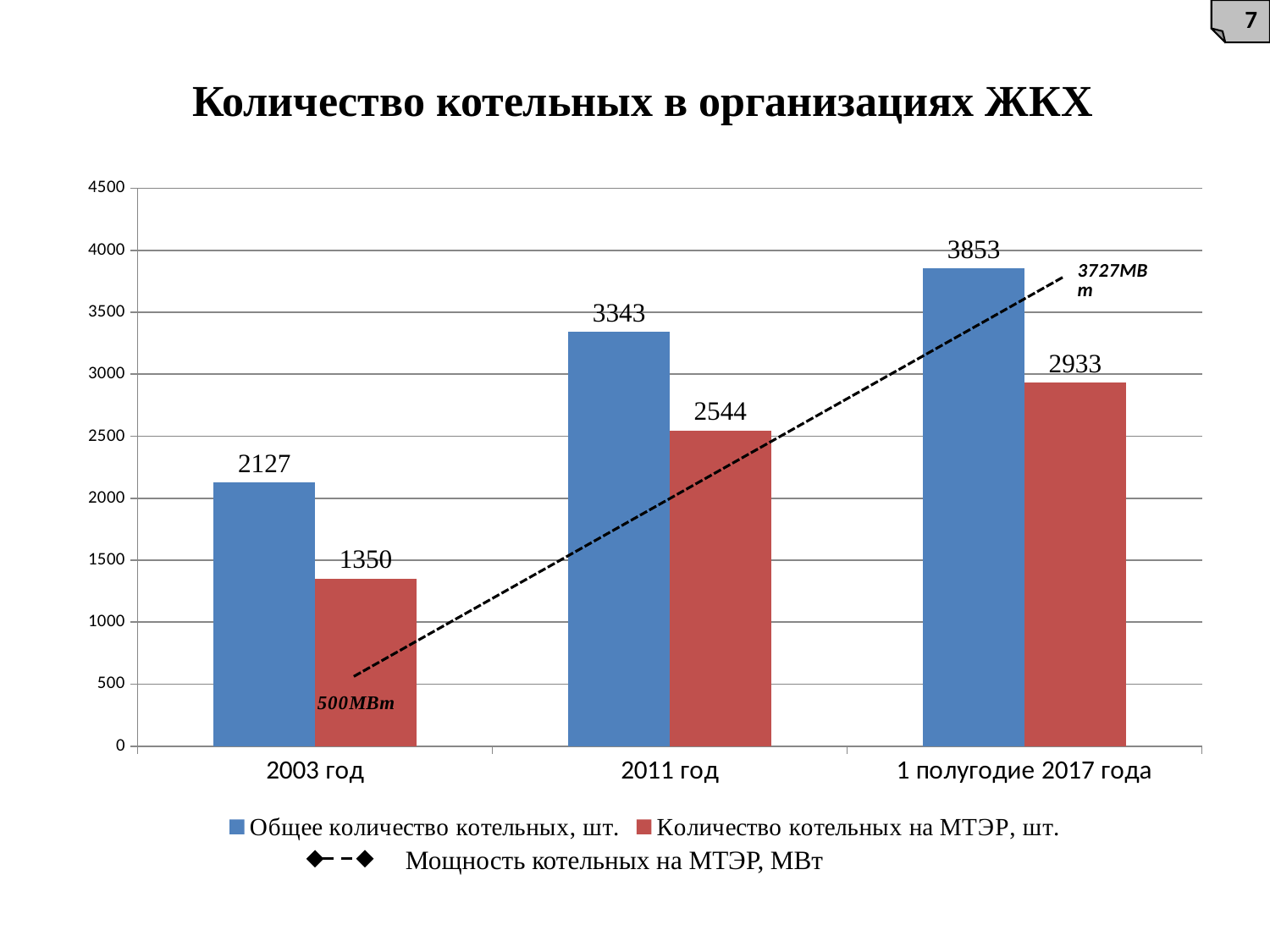
What is the value of "Общее количество котельных, шт." for 2003 год? 2127 Which category has the lowest value for "Количество котельных на МТЭР, шт."? 2003 год How many categories are shown on the x axis? 3 Which is larger: "Общее количество котельных, шт." for 2003 год or "Количество котельных на МТЭР, шт." for 2011 год? Количество котельных на МТЭР, шт. for 2011 год What is the value of "Количество котельных на МТЭР, шт." for 2011 год? 2544 Does "Общее количество котельных, шт." rise or fall from 2003 год to 1 полугодие 2017 года? rise How many series does the legend list? 3 Which category has the highest value for "Общее количество котельных, шт."? 1 полугодие 2017 года Is the value of "Общее количество котельных, шт." for 1 полугодие 2017 года greater or less than 4000? less What is the difference between "Общее количество котельных, шт." and "Количество котельных на МТЭР, шт." for 2011 год? 799 What is the value of "Количество котельных на МТЭР, шт." for 1 полугодие 2017 года? 2933 What kind of chart is shown on the slide? bar chart with a line